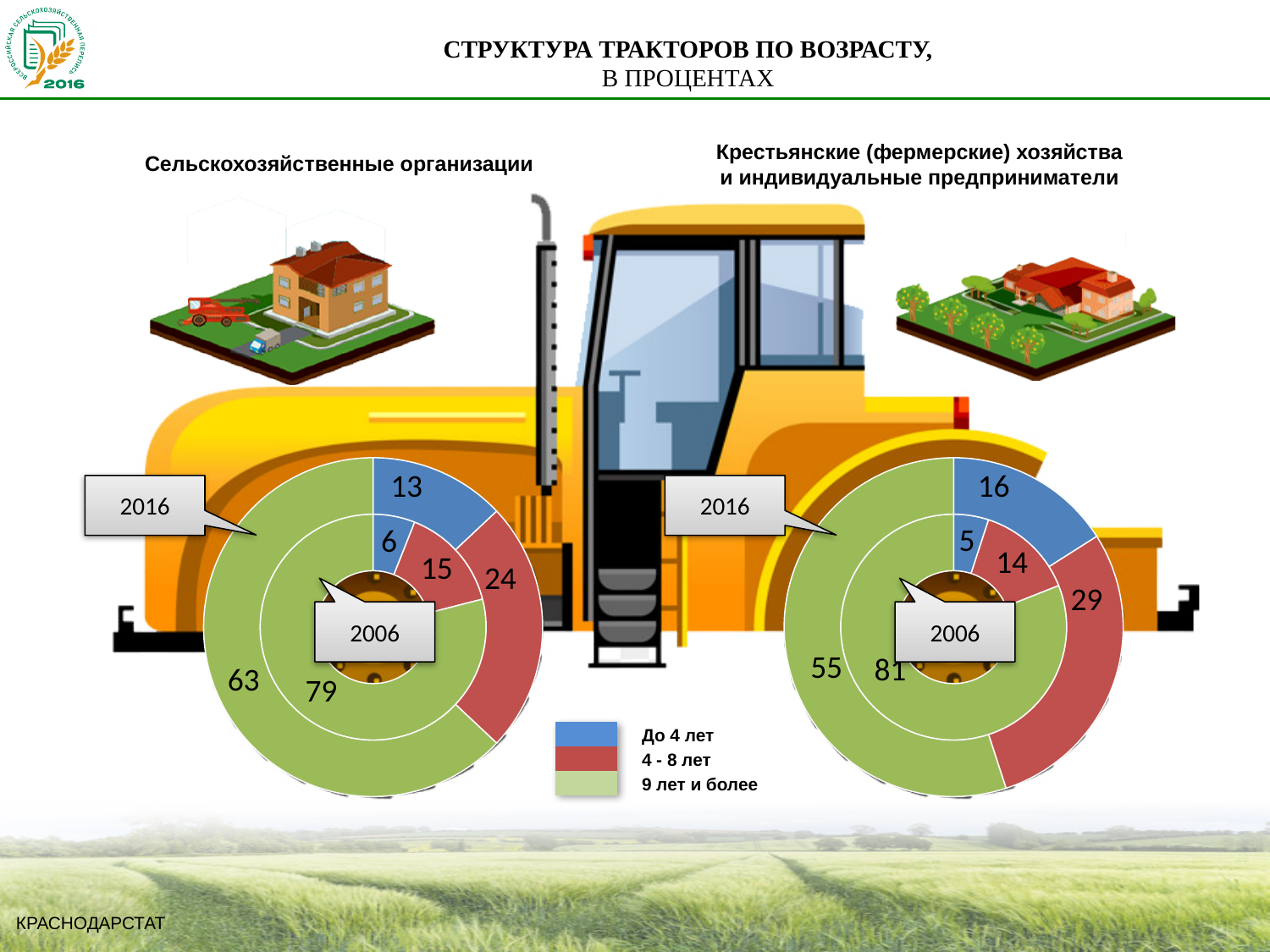
Which is larger: the 2016 share of tractors aged До 4 лет for Сельскохозяйственные организации or for Крестьянские (фермерские) хозяйства и индивидуальные предприниматели? Крестьянские (фермерские) хозяйства и индивидуальные предприниматели On the chart for Крестьянские (фермерские) хозяйства и индивидуальные предприниматели, what is the difference between the 2016 and 2006 shares of tractors aged 4 - 8 лет? 15 On the chart for Сельскохозяйственные организации, by how much did the share of tractors aged 9 лет и более fall from 2006 to 2016? 16 On the chart for Крестьянские (фермерские) хозяйства и индивидуальные предприниматели, what is the 2006 share of tractors aged 9 лет и более? 81 What kind of chart is used on this slide? Doughnut chart On the chart for Крестьянские (фермерские) хозяйства и индивидуальные предприниматели, what is the 2016 share of tractors aged 4 - 8 лет? 29 Which colour represents the age group 4 - 8 лет in the legend? Red How many age groups does the legend list? 3 On the chart for Сельскохозяйственные организации, which age group has the largest share in 2016? 9 лет и более On the chart for Сельскохозяйственные организации, what is the 2016 share of tractors aged 9 лет и более? 63 On the chart for Крестьянские (фермерские) хозяйства и индивидуальные предприниматели, which age group has the smallest share in 2006? До 4 лет On the chart for Сельскохозяйственные организации, what is the 2006 share of tractors aged До 4 лет? 6